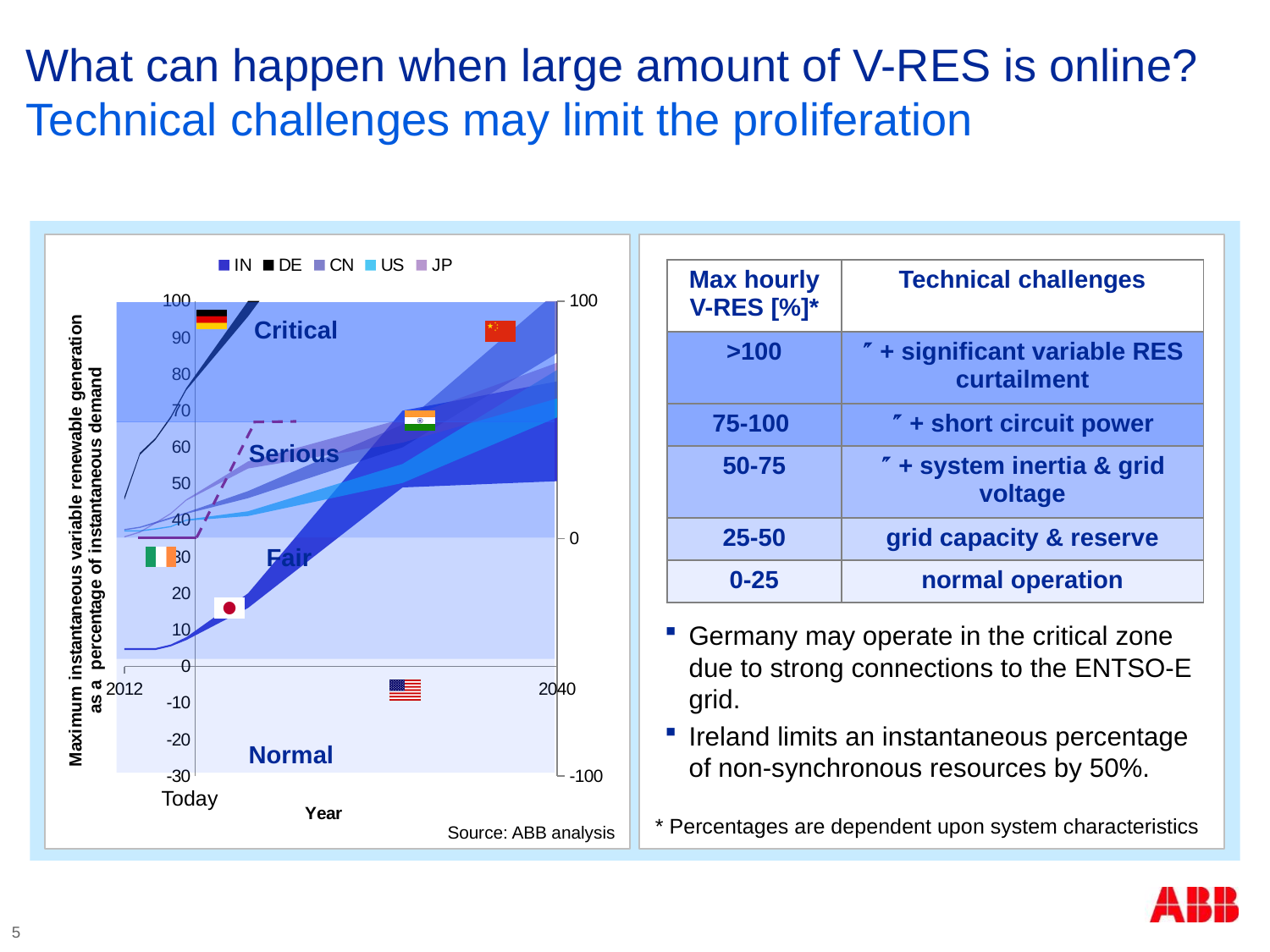
Is the value for DE in 2012 greater or less than 20? greater Which series are listed in the chart's legend? IN, DE, CN, US, JP What is the last year shown on the x axis of the chart? 2040 What is the highest value shown on the left y axis of the chart? 100 What is the label of the x axis of the chart? Year Do the plotted values for the countries rise or fall from 2012 to 2040? rise How many series does the legend of the chart list? 5 Is the value for DE in 2040 greater or less than 90? greater What is the first year shown on the x axis of the chart? 2012 What is the lowest value shown on the left y axis of the chart? -30 What kind of chart is shown on the left of the slide? area chart